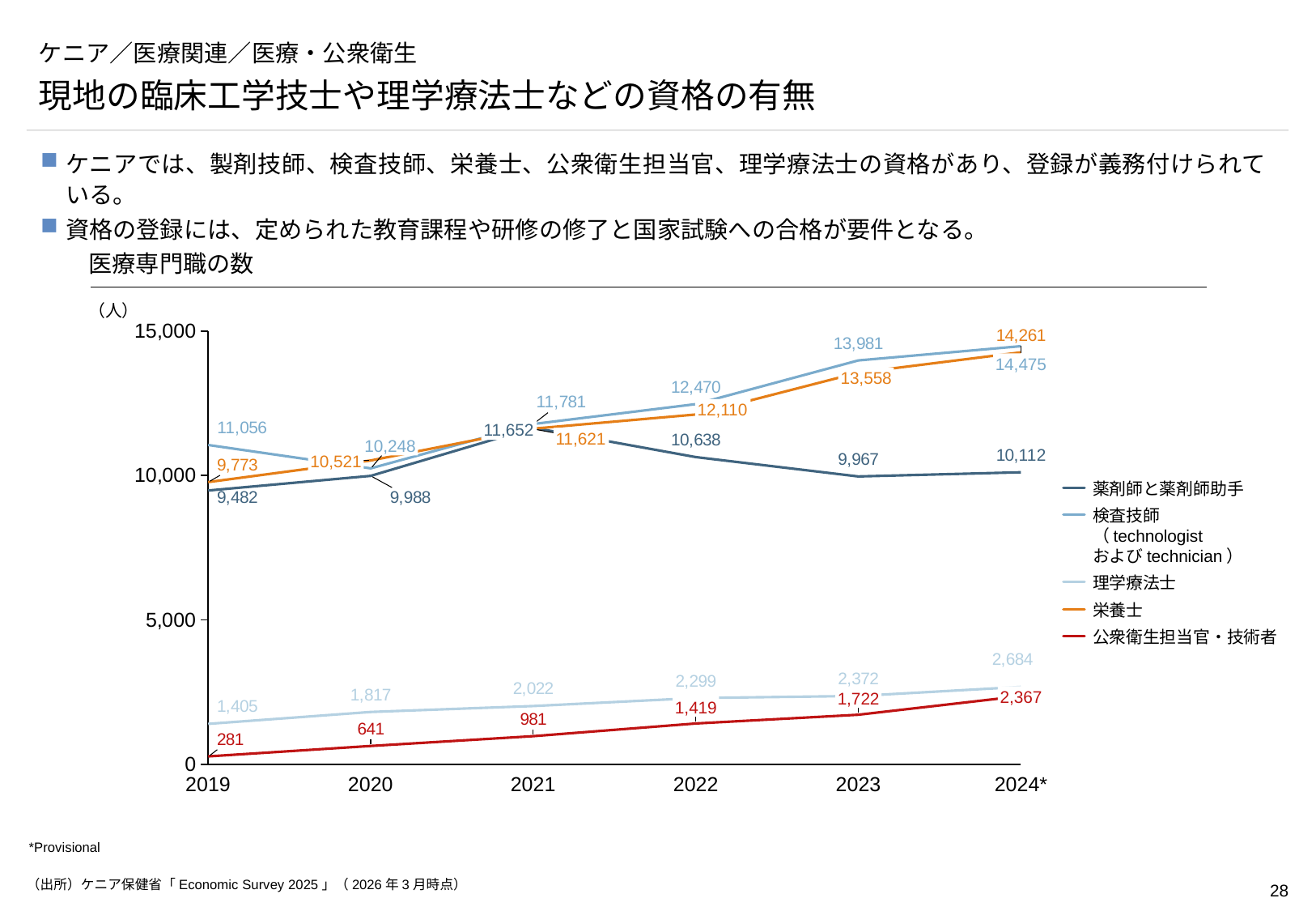
What kind of chart is 医療専門職の数? Line chart In the chart 医療専門職の数, what is the value for 公衆衛生担当官・技術者 in 2019? 281 In the chart 医療専門職の数, in which year is the value for 理学療法士 highest? 2024* How many series does the legend of the chart 医療専門職の数 list? 5 In the chart 医療専門職の数, what is the value for 検査技師 in 2023? 13,981 In the chart 医療専門職の数, which is larger in 2022: 検査技師 or 栄養士? 検査技師 In the chart 医療専門職の数, what is the value for 栄養士 in 2020? 10,521 In the chart 医療専門職の数, what is the difference between the 2024* and 2019 values for 公衆衛生担当官・技術者? 2,086 In the chart 医療専門職の数, does the value for 公衆衛生担当官・技術者 rise or fall from 2019 to 2024*? Rise In the chart 医療専門職の数, what is the value for 薬剤師と薬剤師助手 in 2021? 11,652 In the chart 医療専門職の数, in which year is the value for 栄養士 lowest? 2019 In the chart 医療専門職の数, how many years are shown on the x axis? 6